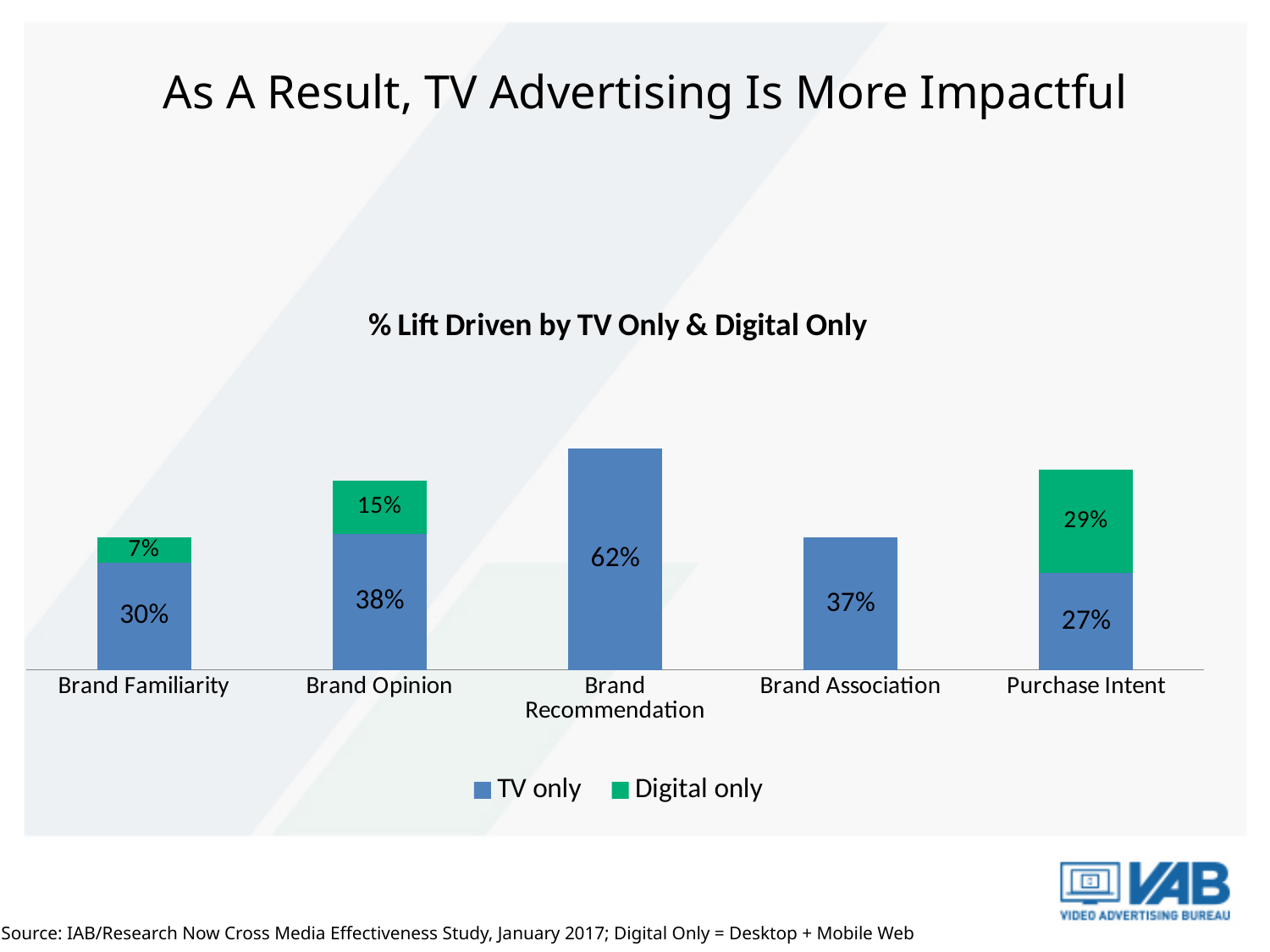
What is the Digital only % lift for Purchase Intent? 29% For Purchase Intent, which is larger: the TV only lift or the Digital only lift? Digital only How many series does the legend list? 2 What is the total % lift (TV only plus Digital only) for the Brand Opinion bar? 53% How many categories are shown on the x axis? 5 Which category has the lowest TV only % lift? Purchase Intent What is the difference between the TV only % lift for Brand Opinion and Brand Familiarity? 8% Which category has the highest TV only % lift? Brand Recommendation What is the TV only % lift for Brand Familiarity? 30% What kind of chart is shown on the slide? Stacked bar chart What is the TV only % lift for Brand Recommendation? 62% What is the Digital only % lift for Brand Opinion? 15%